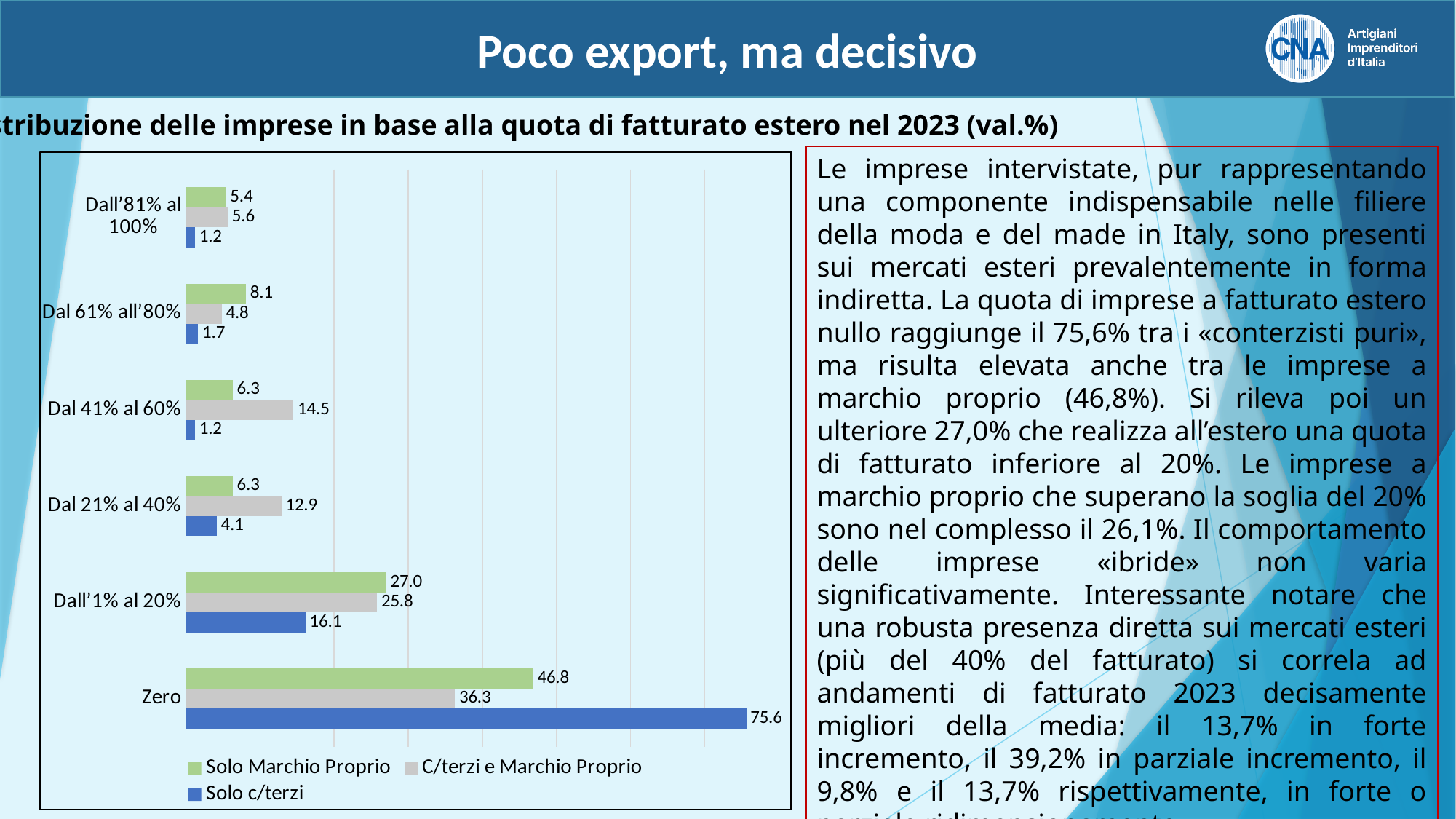
Which category has the lowest value for C/terzi e Marchio Proprio? Dal 61% all'80% Which category has the highest value for Solo Marchio Proprio? Zero What is the difference between the Solo c/terzi value and the Solo Marchio Proprio value in the Zero category? 28.8 What is the value for Solo Marchio Proprio in the Dall'1% al 20% category? 27.0 What kind of chart is shown on the slide? Bar chart How many series does the legend list? 3 What is the value for Solo c/terzi in the Zero category? 75.6 In the Dal 41% al 60% category, which series has the larger value: Solo Marchio Proprio or C/terzi e Marchio Proprio? C/terzi e Marchio Proprio How many categories are shown on the chart? 6 Which series is shown in blue in the legend? Solo c/terzi What is the value for Solo c/terzi in the Dal 21% al 40% category? 4.1 What is the value for C/terzi e Marchio Proprio in the Dal 41% al 60% category? 14.5